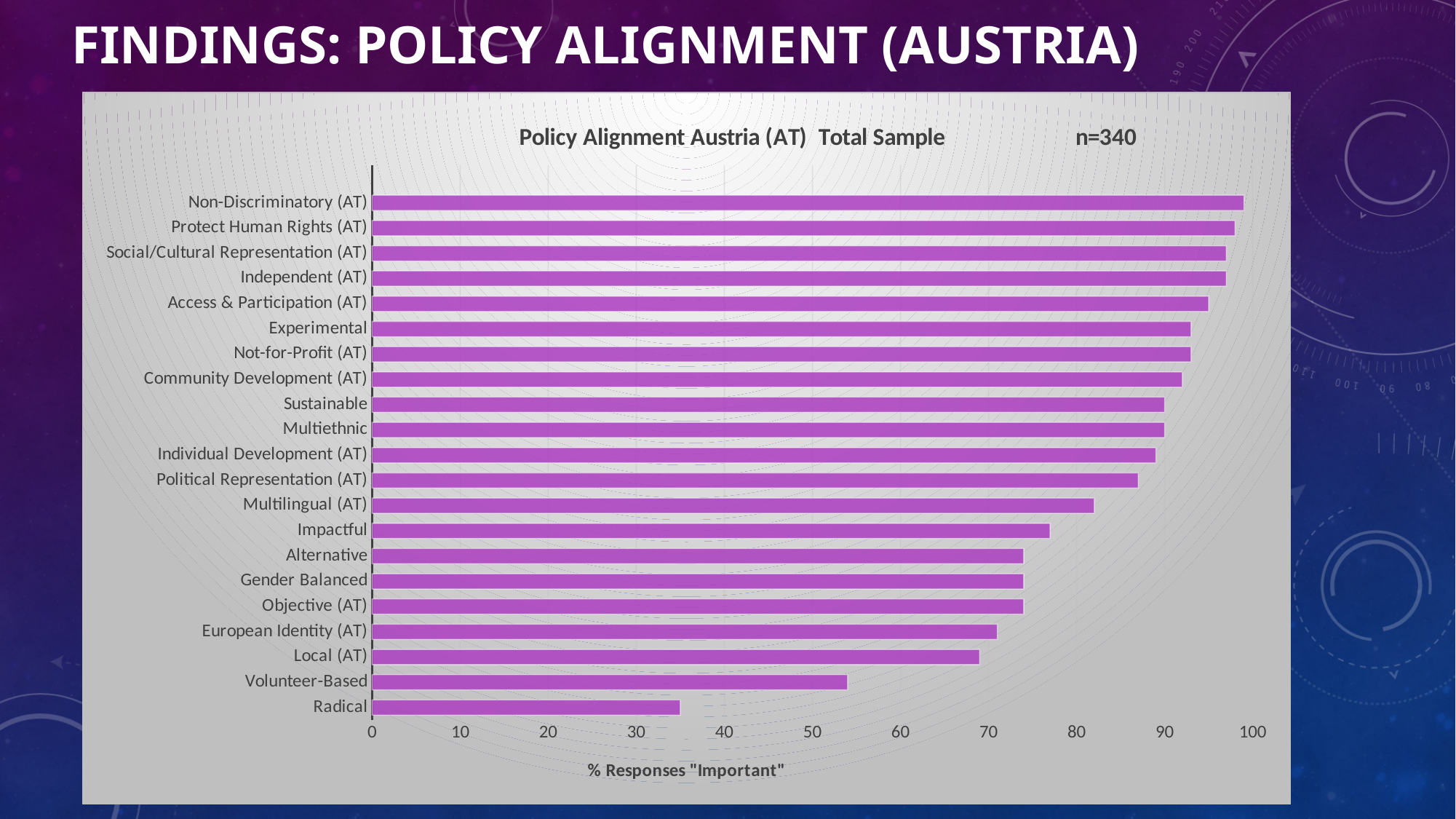
Is the value for Impactful greater or less than 80? less What is the sample size shown in the chart title? n=340 Which category has the highest percentage of "Important" responses? Non-Discriminatory (AT) Is the value for Non-Discriminatory (AT) greater or less than 90? greater Which category has the lowest percentage of "Important" responses? Radical Is the value for Volunteer-Based greater or less than 50? greater How many categories are plotted in the chart? 21 Which has a larger value, Volunteer-Based or Radical? Volunteer-Based What kind of chart is shown on the slide? bar chart Which has a larger value, Multilingual (AT) or Impactful? Multilingual (AT)